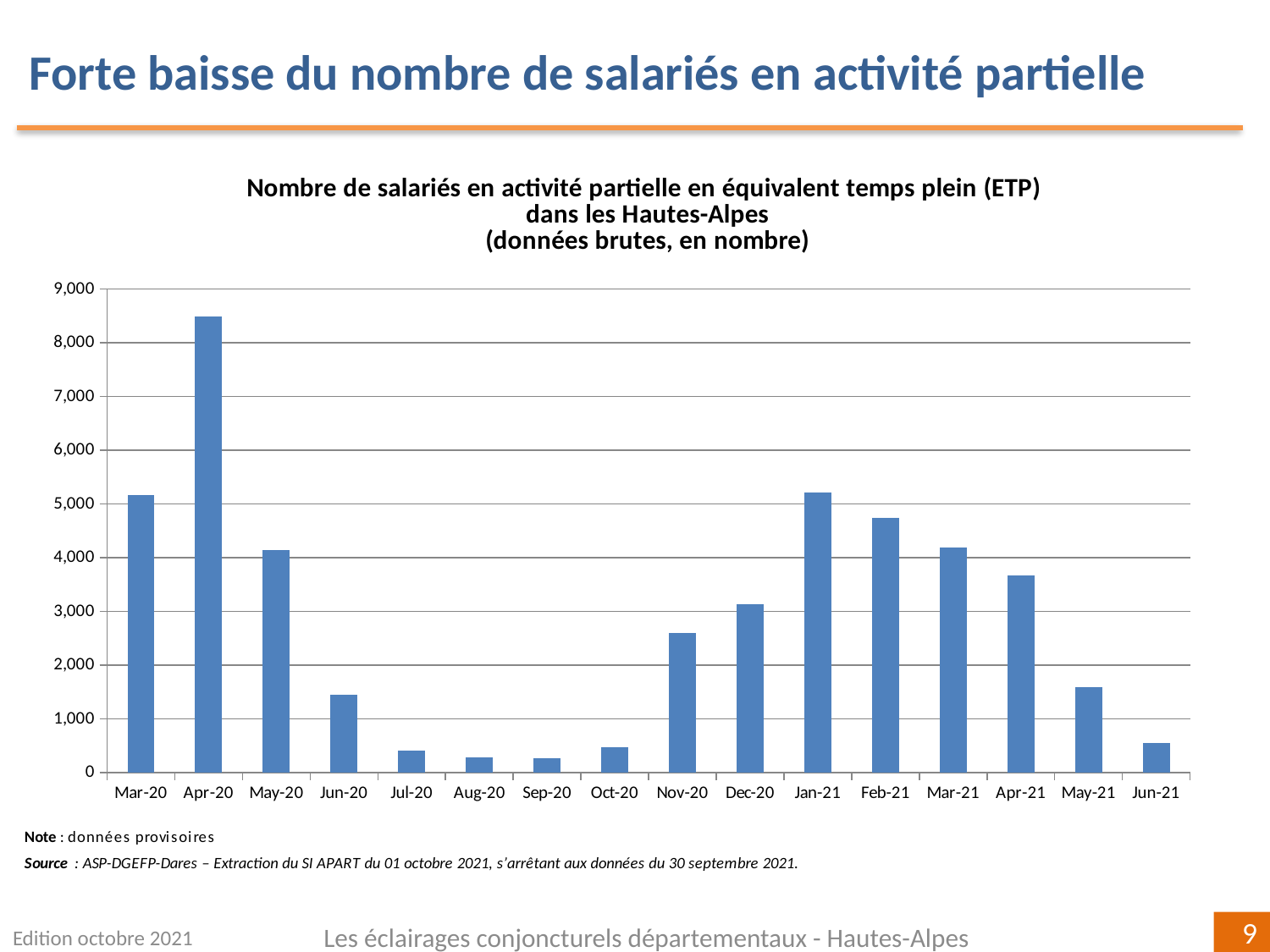
Which département does the chart title say the data covers? Hautes-Alpes Which month has the highest number of salariés en activité partielle (ETP)? Apr-20 How many months are plotted on the x axis of the chart? 16 Which is larger, the value for Apr-20 or the value for Jan-21? Apr-20 Is the value for Jan-21 greater or less than 5,000? greater Is the value for Apr-20 greater or less than 8,000? greater Do the values rise or fall from Jan-21 to Jun-21? fall Is the value for Jun-20 greater or less than 2,000? less What kind of chart is shown on the slide? bar chart Which is larger, the value for Nov-20 or the value for Dec-20? Dec-20